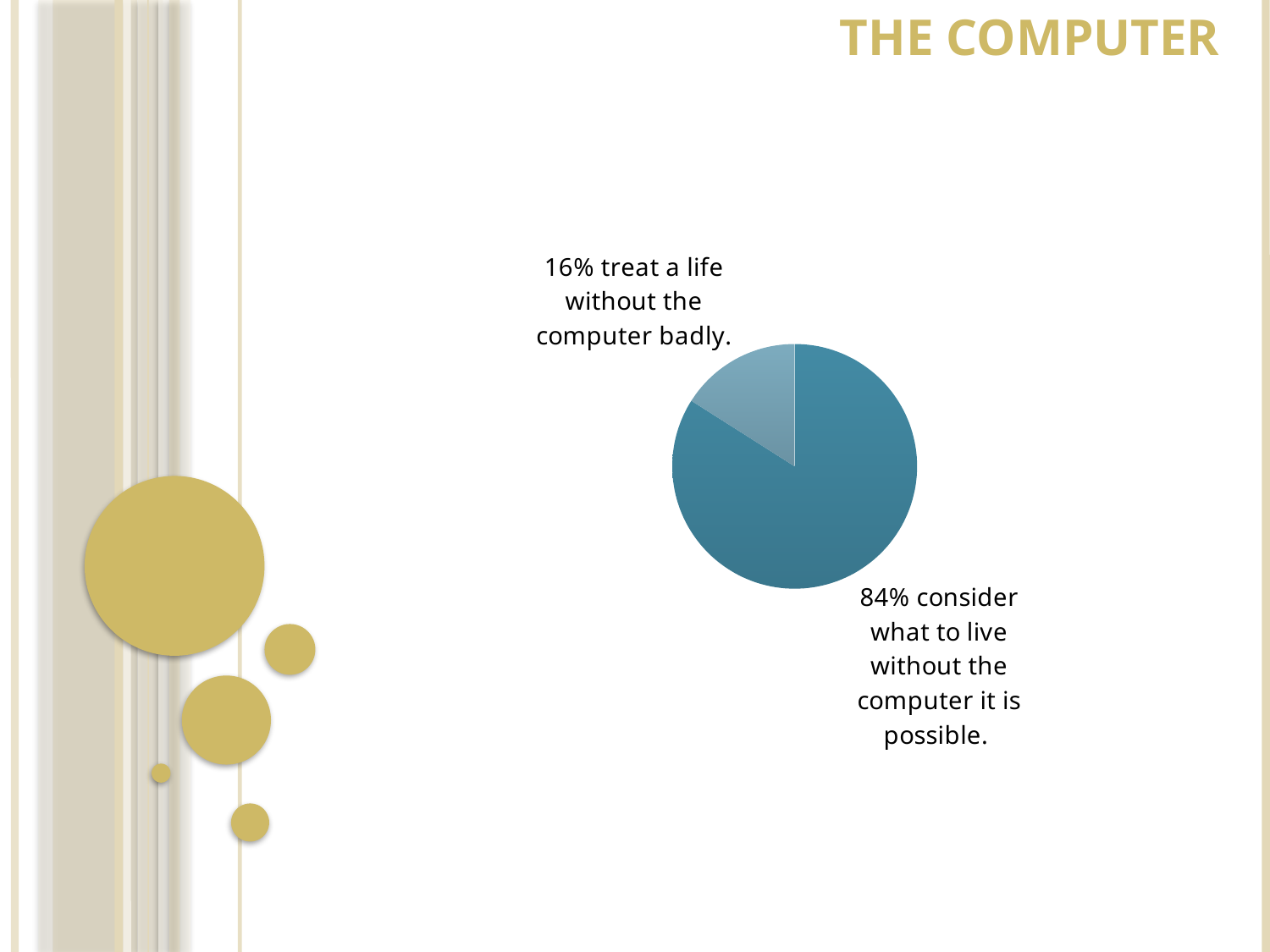
What is the total of the two slices shown in the pie chart? 100% Which slice is the smallest in the pie chart? 16% treat a life without the computer badly. What kind of chart is shown on the slide? pie chart Which slice is the largest in the pie chart? 84% consider what to live without the computer it is possible. What is the title of the slide containing the pie chart? THE COMPUTER How many slices does the pie chart have? 2 Which is larger: the share that considers living without the computer possible, or the share that treats a life without the computer badly? the share that considers living without the computer possible What is the difference in percentage points between the two slices of the pie chart? 68 What share of the pie is for those who treat a life without the computer badly? 16% What share of the pie is for those who consider it possible to live without the computer? 84% Is the share of people who treat a life without the computer badly greater or less than 50%? less